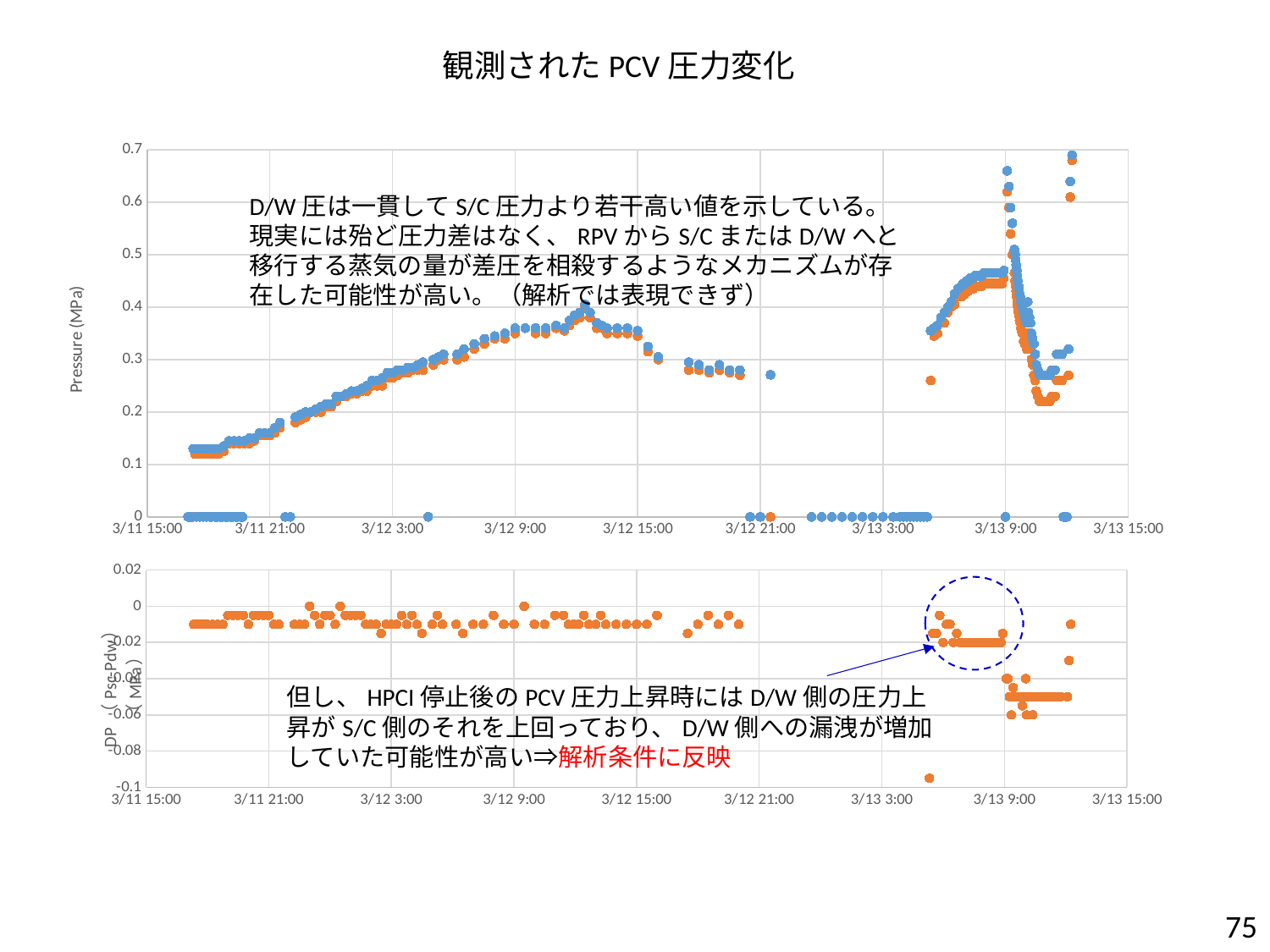
In the bottom chart, are the DP values after 3/13 9:00 greater or less than -0.02? less In the top chart, do the pressure values rise or fall between 3/12 12:00 and 3/12 21:00? fall What kind of chart is the top chart on the slide? scatter chart In the top chart, is the pressure value at 3/12 9:00 greater or less than 0.3? greater In the top chart, is the pressure value at 3/11 21:00 greater or less than 0.2? less How many charts are shown on the slide? 2 What is the lowest tick value on the y-axis of the bottom chart? -0.1 What is the y-axis label of the top chart? Pressure (MPa) In the top chart, do the pressure values rise or fall between 3/11 15:00 and 3/12 9:00? rise What is the highest tick value on the y-axis of the top chart? 0.7